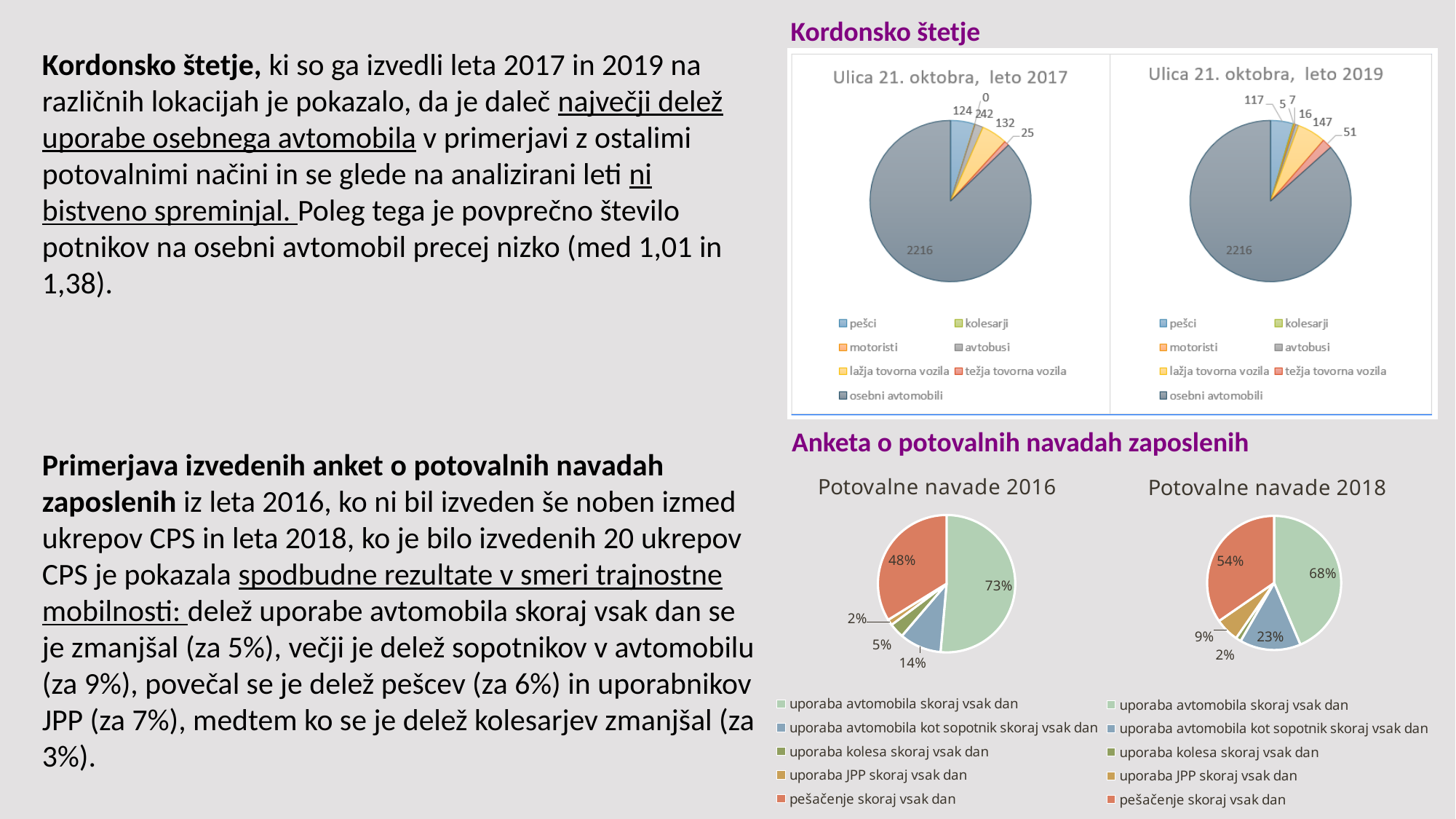
In the 'Potovalne navade 2018' pie chart, what is the value for 'pešačenje skoraj vsak dan'? 54% In the 'Ulica 21. oktobra, leto 2019' pie chart, what is the value for 'pešci'? 117 In the 'Potovalne navade 2018' pie chart, which category has the smallest value? uporaba kolesa skoraj vsak dan What is the difference between the 'uporaba avtomobila skoraj vsak dan' value in the 'Potovalne navade 2016' chart and in the 'Potovalne navade 2018' chart? 5% In the 'Potovalne navade 2016' pie chart, which category has the largest value? uporaba avtomobila skoraj vsak dan In the 'Ulica 21. oktobra, leto 2017' pie chart, what is the value for 'osebni avtomobili'? 2216 In the 'Potovalne navade 2016' pie chart, what is the value for 'uporaba JPP skoraj vsak dan'? 2% In the 'Potovalne navade 2016' pie chart, what is the value for 'uporaba avtomobila skoraj vsak dan'? 73% In the 'Potovalne navade 2018' pie chart, what is the value for 'uporaba avtomobila kot sopotnik skoraj vsak dan'? 23% What kind of chart is 'Potovalne navade 2018'? pie chart Which is larger: 'uporaba JPP skoraj vsak dan' in the 'Potovalne navade 2016' chart or in the 'Potovalne navade 2018' chart? Potovalne navade 2018 How many categories does the legend of the 'Ulica 21. oktobra, leto 2019' chart list? 7